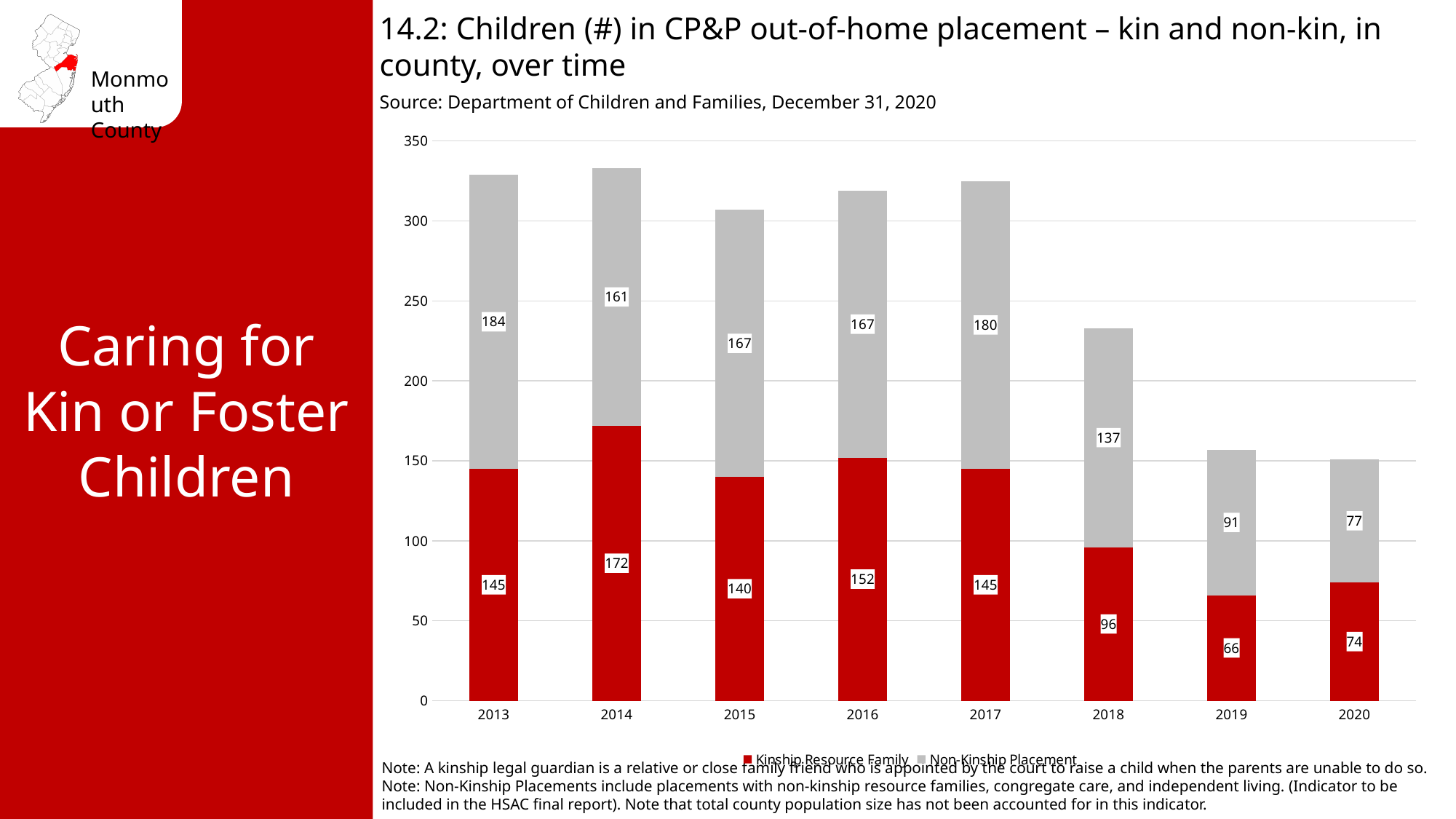
What is the Kinship Resource Family value for 2014? 172 Which year has the highest Non-Kinship Placement value? 2013 What is the total number of children in out-of-home placement in 2020 (both series combined)? 151 Which series is shown in red in the chart? Kinship Resource Family Which is larger in 2018: the Kinship Resource Family value or the Non-Kinship Placement value? Non-Kinship Placement What is the Non-Kinship Placement value for 2017? 180 What is the difference between the Non-Kinship Placement values for 2013 and 2020? 107 How many series does the chart's legend list? 2 How many years are shown on the x axis of the chart? 8 What type of chart is shown on the slide? Stacked bar chart Which year has the lowest Kinship Resource Family value? 2019 What is the Kinship Resource Family value for 2019? 66